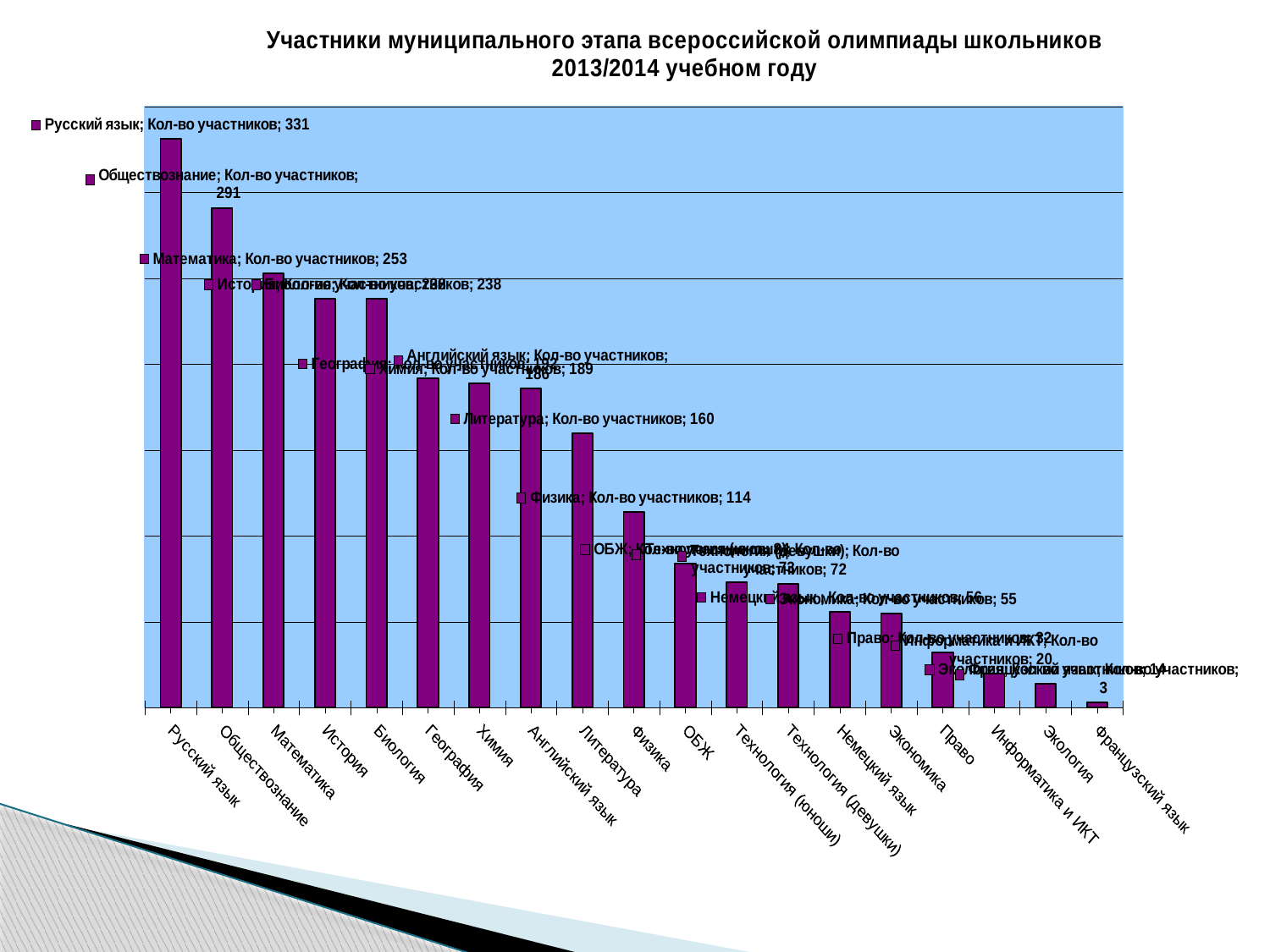
What is the number of participants for Литература? 160 What is the number of participants for Физика? 114 Which has more participants, Математика or Литература? Математика How many subjects are shown on the x axis? 19 What is the difference in participants between Русский язык and Обществознание? 40 Which subject has the highest number of participants? Русский язык What is the number of participants for Обществознание? 291 What is the difference in participants between Экономика and Информатика и ИКТ? 35 What is the number of participants for Французский язык? 3 Which subject has the lowest number of participants? Французский язык Do the values rise or fall from left to right along the x axis? fall What is the number of participants for Русский язык? 331